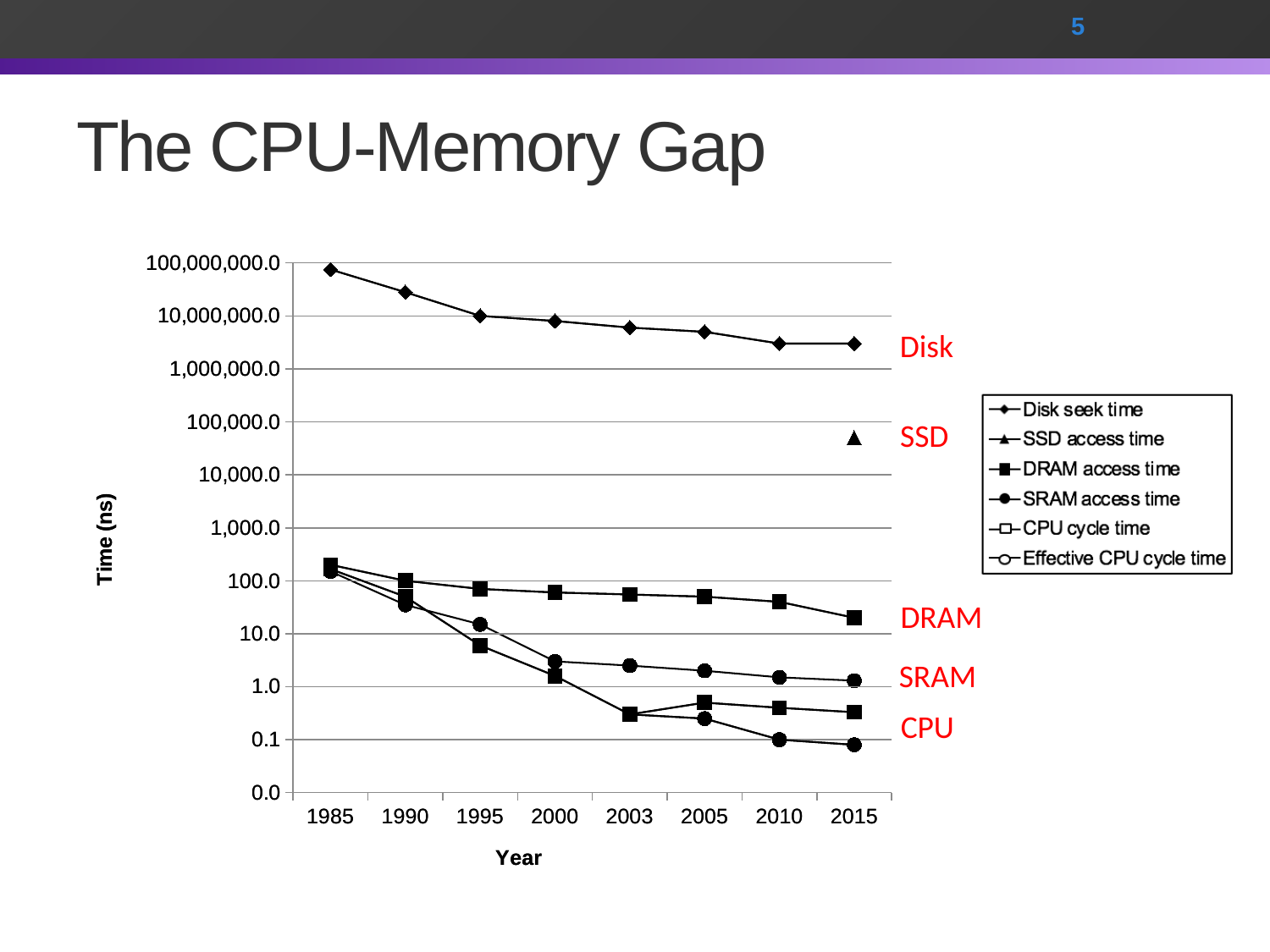
How many series does the legend list? 6 How many years are shown on the x axis? 8 In 2015, which is larger: DRAM access time or SRAM access time? DRAM access time What kind of chart is shown on the slide? line chart Is the Disk seek time in 2015 greater or less than 10,000,000? less What is the title of the x axis? Year Is the Disk seek time in 1985 greater or less than 10,000,000? greater Is the SSD access time in 2015 greater or less than 10,000? greater What is the title of the y axis? Time (ns) Does the Disk seek time rise or fall from 1985 to 2015? fall Which series has the highest value in 1985? Disk seek time